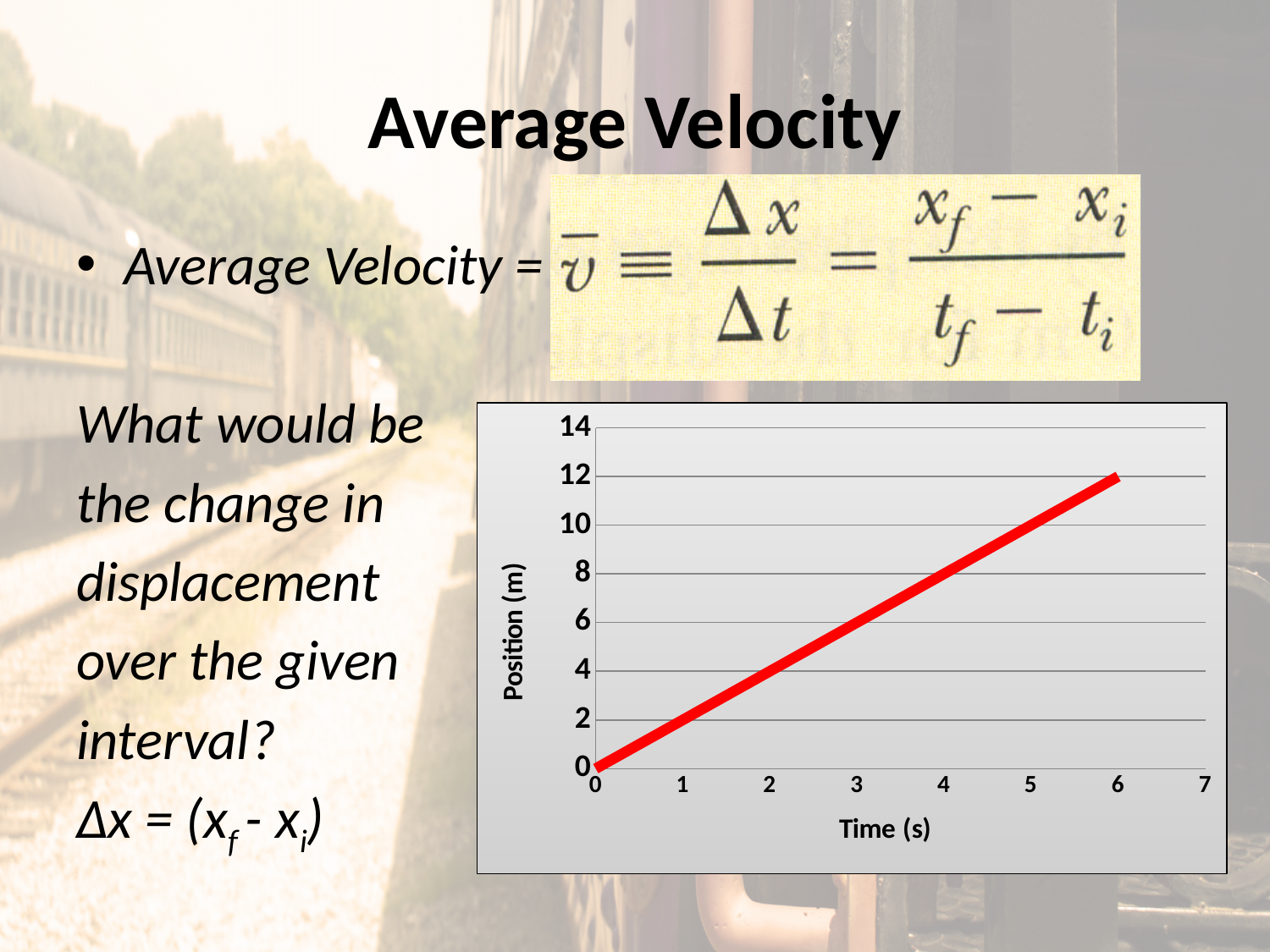
What is the position at time 6 s, where the line ends? 12 Is the position at time 2 s greater or less than 6? less What is the label of the vertical axis of the chart? Position (m) Does the position rise or fall as time increases along the x axis? rise What is the position at time 3 s? 6 What is the label of the horizontal axis of the chart? Time (s) What is the position at time 0 s? 0 Is the position at time 6 s larger than the position at time 1 s? yes What kind of chart is shown on the slide? line chart At which time shown on the x axis does the line reach its highest position? 6 What is the change in position between time 0 s and time 6 s? 12 Is the position at time 5 s greater or less than 8? greater